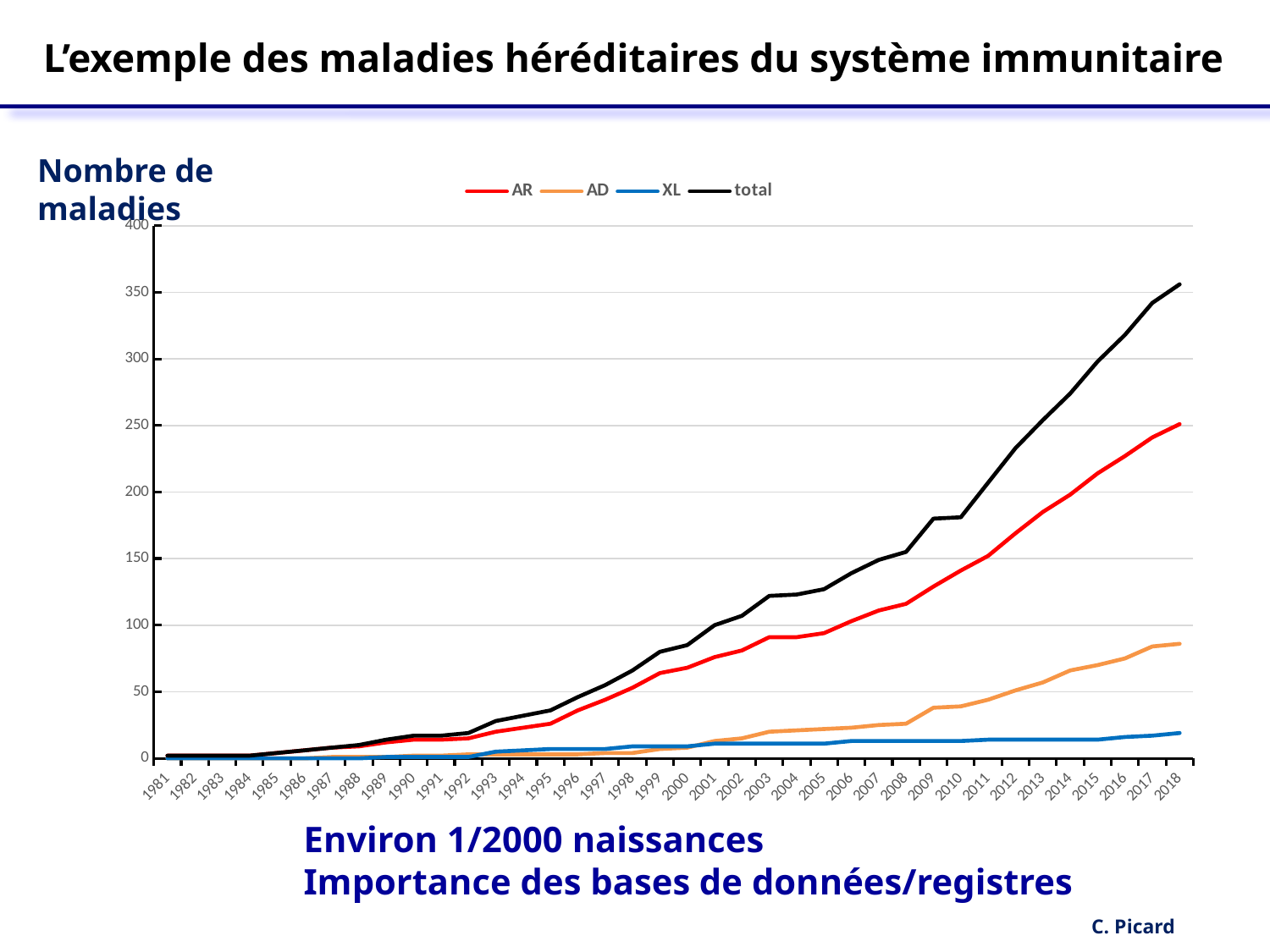
Which series has the lowest value in 2018? XL In 2018, which is larger, the value for AR or the value for AD? AR What kind of chart is shown on the slide? line chart Is the value of 'total' in 2000 greater or less than 100? less Is the value of 'AD' in 2018 greater or less than 100? less Which series has the highest value in 2018? total Is the value of 'total' in 2018 greater or less than 300? greater How many years are shown along the x axis? 38 Which series are listed in the legend? AR, AD, XL, total What colour is the line for the 'total' series? black How many series does the legend list? 4 Does the 'total' series rise or fall from 1981 to 2018? rise